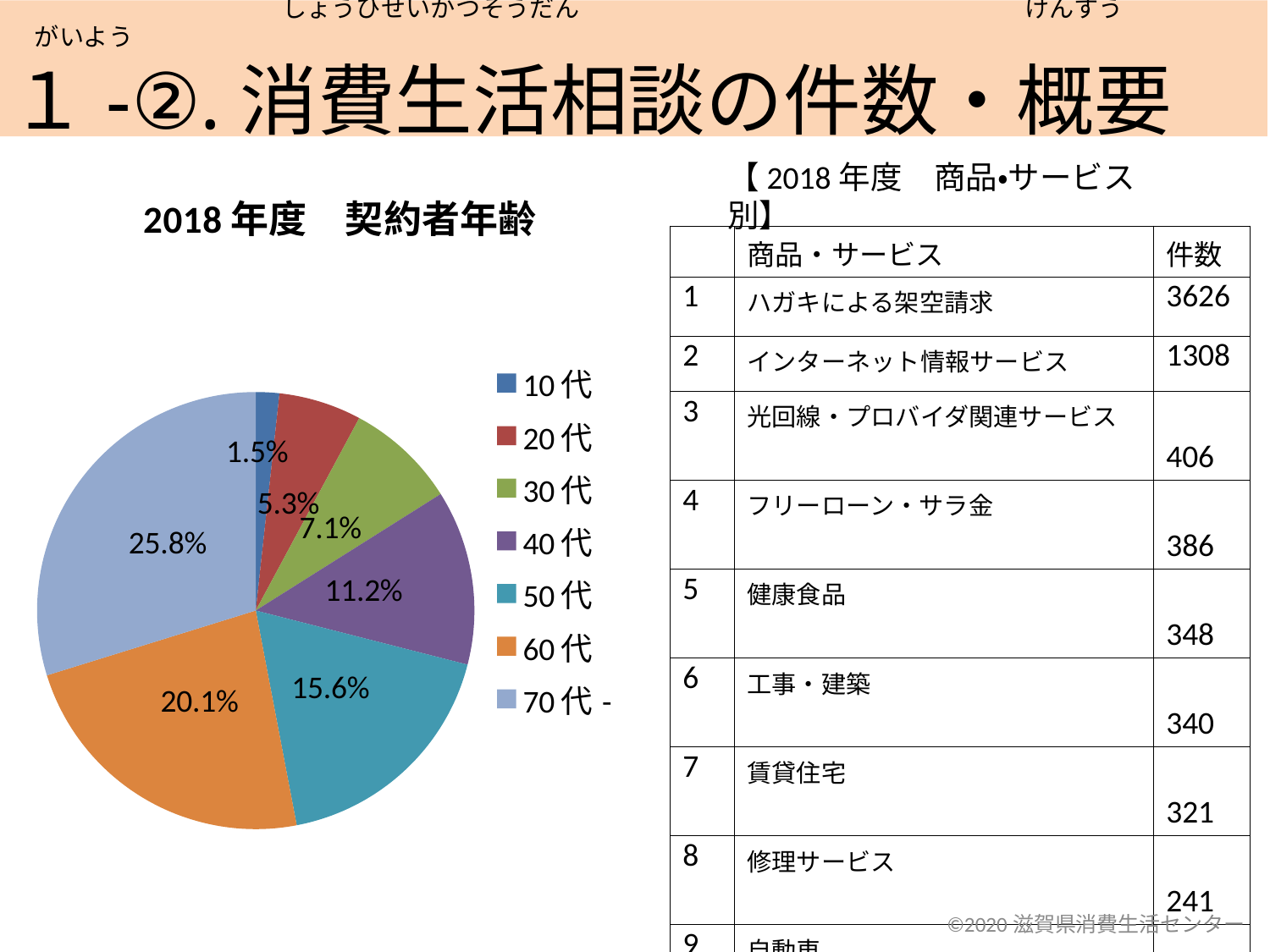
What percentage does the pie chart show for 70代-? 25.8% What percentage does the pie chart show for 60代? 20.1% How many categories does the pie chart's legend list? 7 What percentage does the pie chart show for 10代? 1.5% Which age group has the smallest share in the pie chart? 10代 Which age group has the largest share in the pie chart? 70代- In the pie chart, which is larger, the share for 50代 or the share for 30代? 50代 What is the title of the pie chart? 2018年度 契約者年齢 What kind of chart is shown on the left of the slide? pie chart What percentage does the pie chart show for 40代? 11.2% In the pie chart, what colour is the slice for 60代? orange In the pie chart, what is the difference between the share for 60代 and the share for 50代? 4.5%